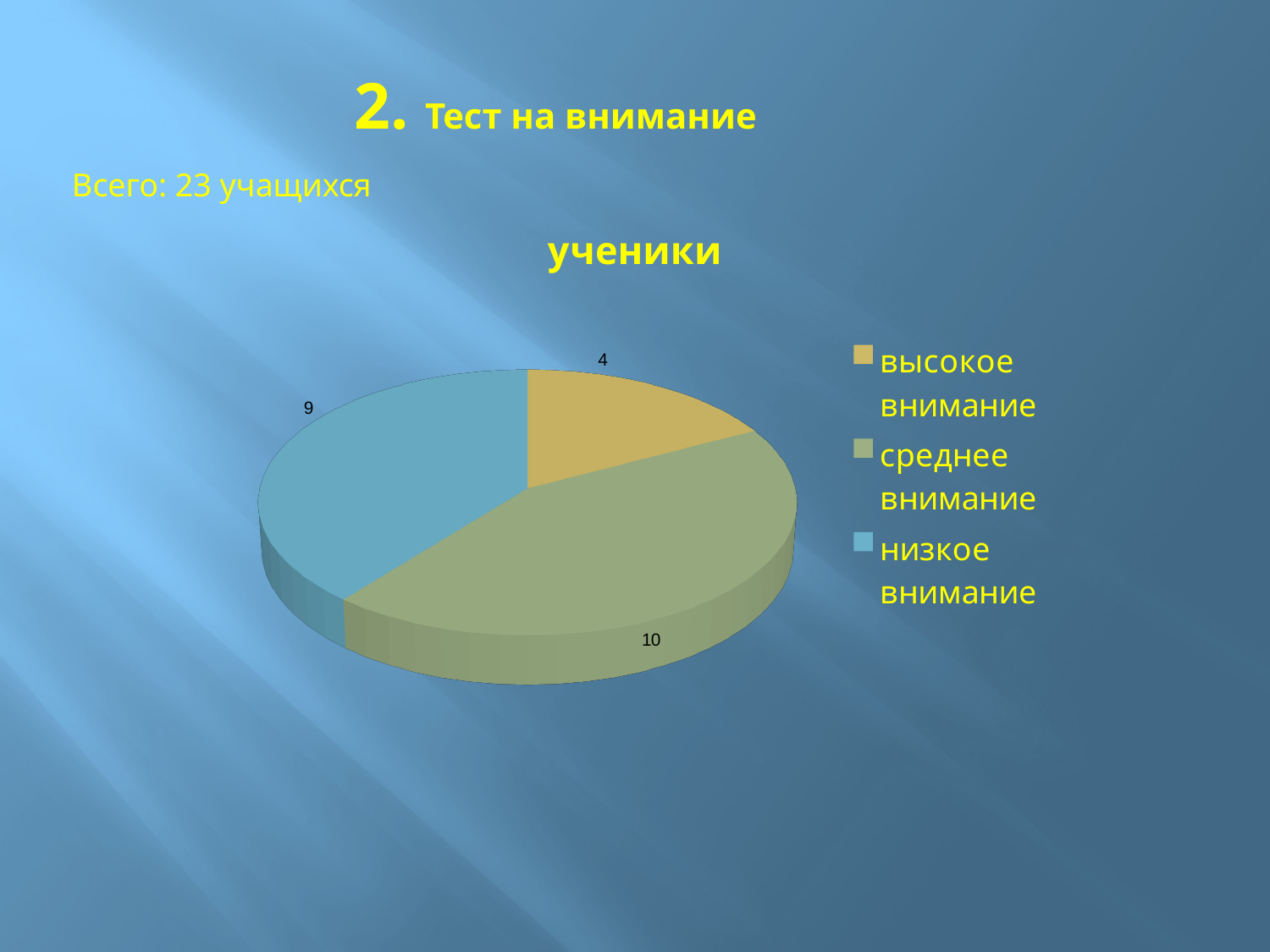
Which category has the smallest slice? высокое внимание What is the difference between the values for среднее внимание and высокое внимание? 6 What is the chart's title? ученики What is the value for среднее внимание? 10 Which is larger, the value for низкое внимание or the value for высокое внимание? низкое внимание What is the total of all slices in the pie chart? 23 Which category has the largest slice? среднее внимание What is the value for низкое внимание? 9 What type of chart is shown on the slide? pie chart What is the value for высокое внимание? 4 How many slices does the pie chart have? 3 Which legend entry is shown in blue? низкое внимание